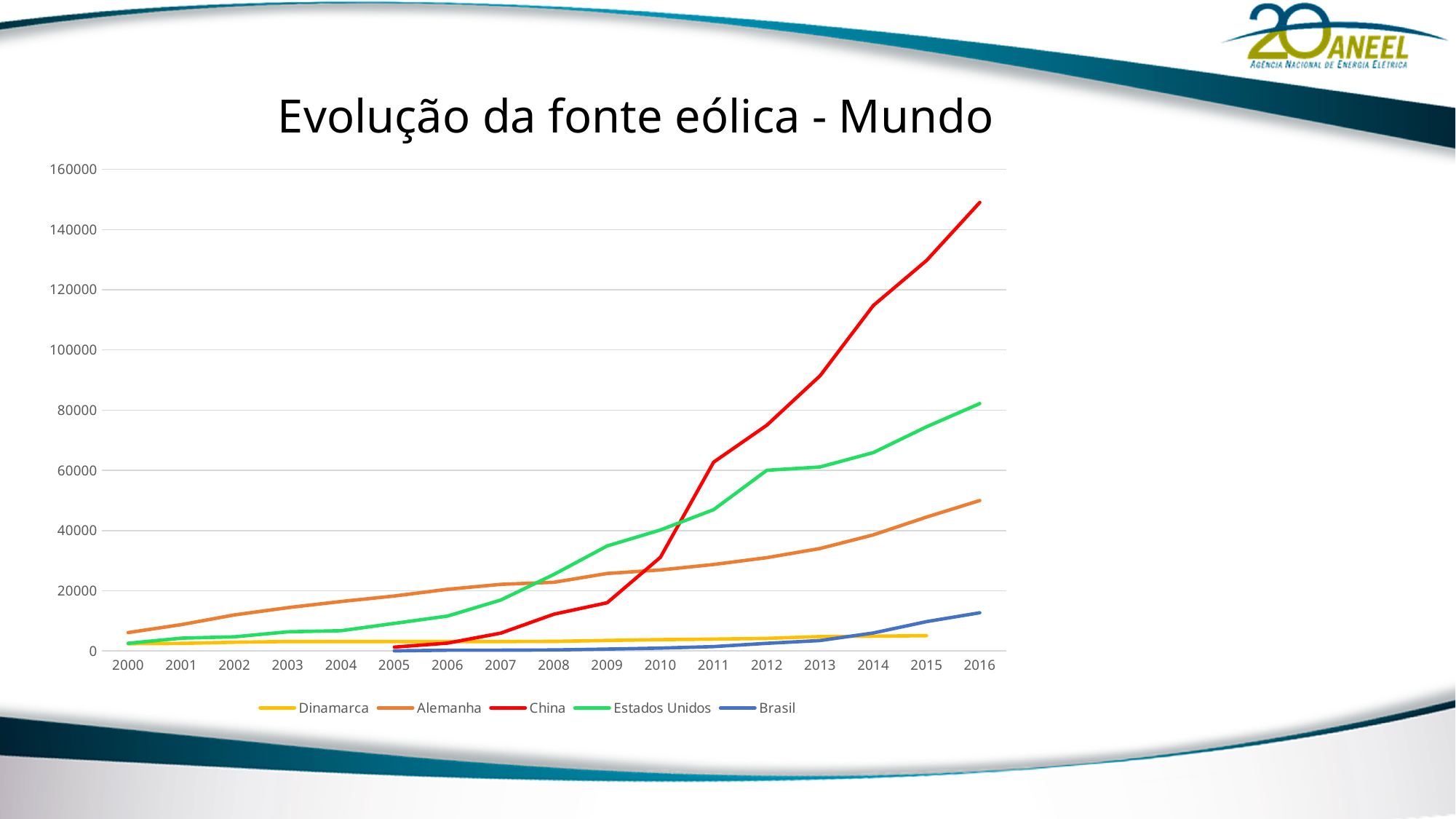
Which series has the highest value in 2005? Alemanha What kind of chart is shown on the slide? line chart In 2010, which is larger: the value for Estados Unidos or the value for Alemanha? Estados Unidos Is the value for Alemanha in 2016 greater or less than 60000? less What is the title of the chart? Evolução da fonte eólica - Mundo Does the China line rise or fall from 2005 to 2016? rises Which series has the highest value in 2016? China How many years are shown on the x axis? 17 How many series does the legend list? 5 Is the value for China in 2016 greater or less than 140000? greater What colour is the line for China? red Which series has the lowest value in 2016? Brasil